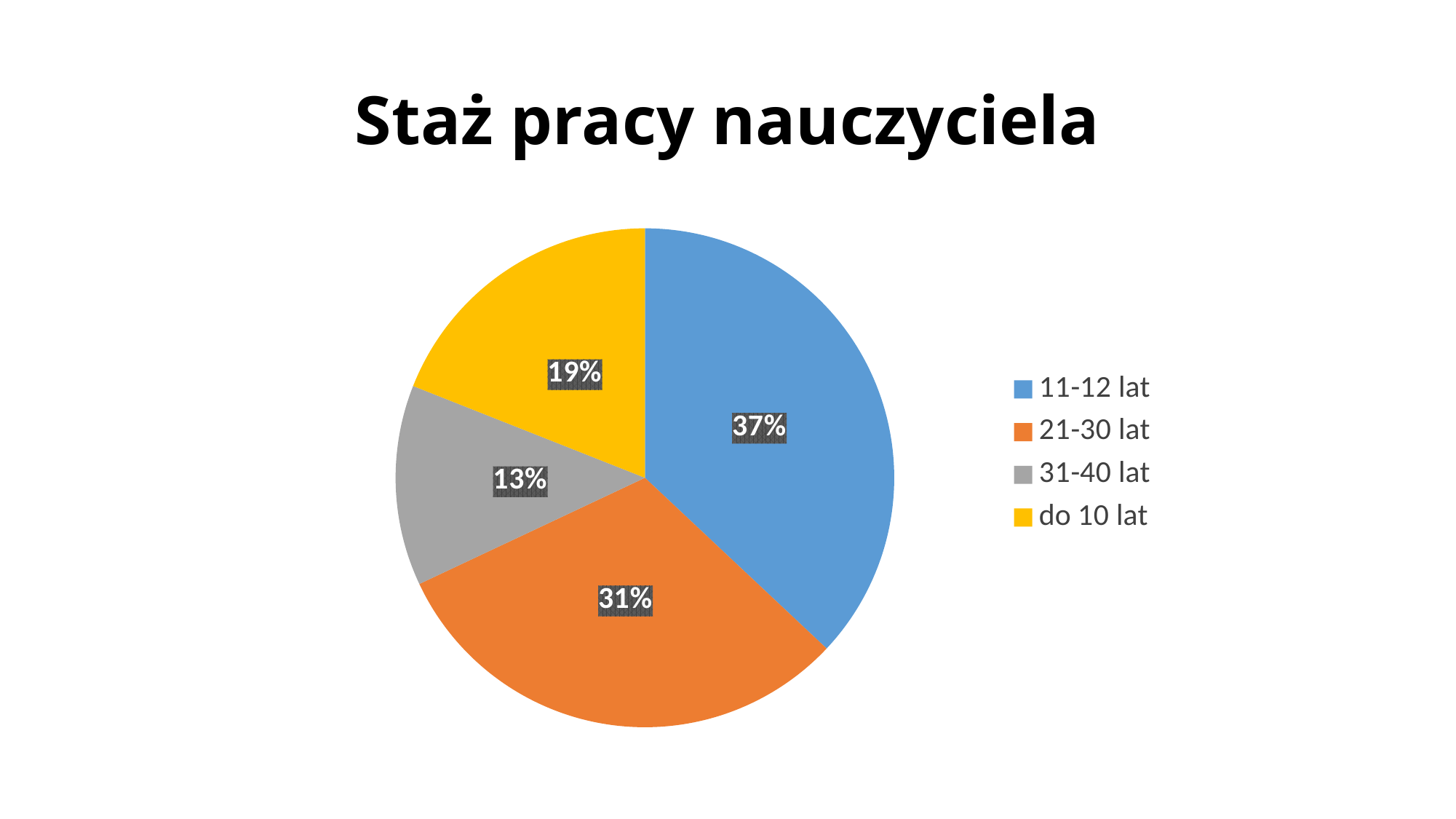
How many categories are shown in the pie chart? 4 What is the difference in percentage points between the '11-12 lat' slice and the '21-30 lat' slice? 6 What kind of chart is shown on the slide? pie chart What share of the pie does the 'do 10 lat' slice represent? 19% What is the title of the chart? Staż pracy nauczyciela Which category has the smallest slice of the pie? 31-40 lat What share of the pie does the '21-30 lat' slice represent? 31% What share of the pie does the '31-40 lat' slice represent? 13% Which category has the largest slice of the pie? 11-12 lat What is the difference in percentage points between the 'do 10 lat' slice and the '31-40 lat' slice? 6 Which slice is larger, 'do 10 lat' or '31-40 lat'? do 10 lat